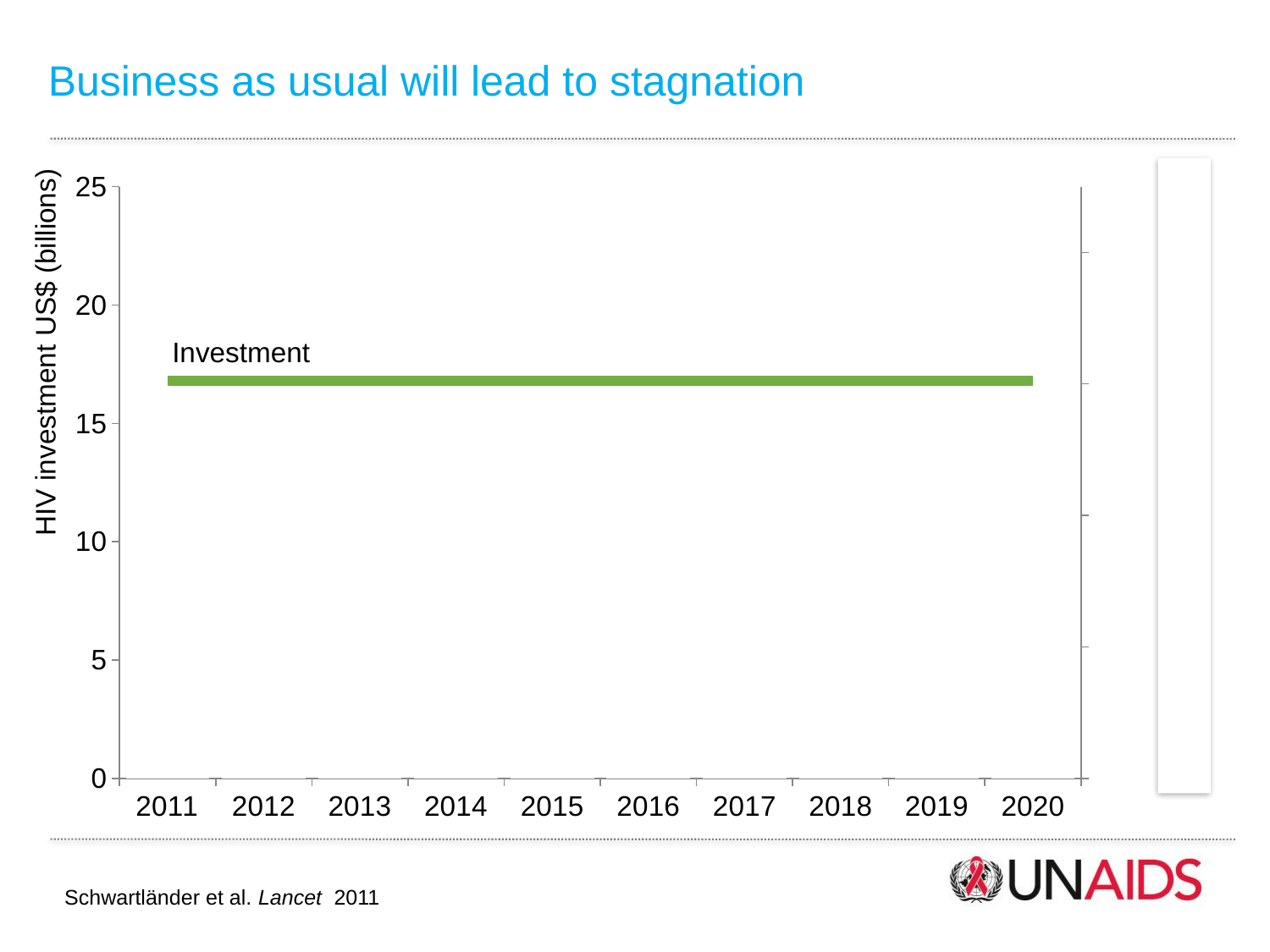
Is the Investment value for 2020 greater or less than 20? less How many data series are plotted on the chart? 1 What is the first year shown on the x axis? 2011 What is the label of the line plotted on the chart? Investment Is the Investment value for 2011 greater or less than 15? greater What is the label of the y axis? HIV investment US$ (billions) What kind of chart is shown on the slide? Line chart What is the highest value shown on the y axis? 25 Is the Investment value for 2015 greater or less than 10? greater Does the Investment line rise, fall, or stay flat from 2011 to 2020? Stays flat How many years are shown along the x axis of the chart? 10